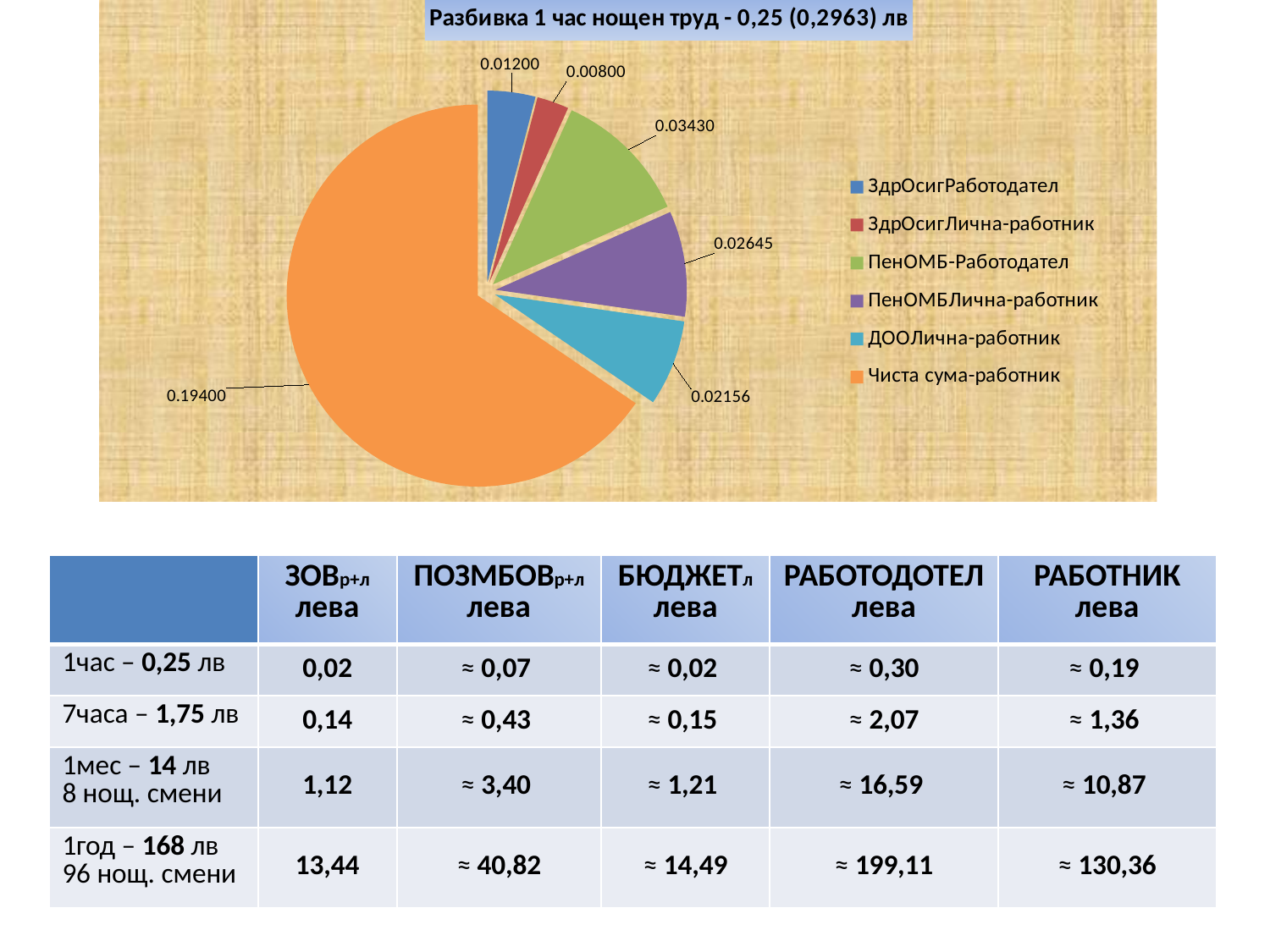
What kind of chart is shown on the slide? pie chart What is the difference between the values for Чиста сума-работник and ПенОМБ-Работодател? 0.15970 Which category has the smallest slice in the pie chart? ЗдрОсигЛична-работник What is the value of the slice for Чиста сума-работник? 0.19400 What is the value of the slice for ЗдрОсигЛична-работник? 0.00800 What is the value of the slice for ПенОМБ-Работодател? 0.03430 What is the value of the slice for ДООЛична-работник? 0.02156 Which category has the largest slice in the pie chart? Чиста сума-работник What is the title of the pie chart? Разбивка 1 час нощен труд - 0,25 (0,2963) лв How many slices does the pie chart have? 6 How many entries does the legend of the pie chart list? 6 Which is larger, the slice for ПенОМБЛична-работник or the slice for ДООЛична-работник? ПенОМБЛична-работник